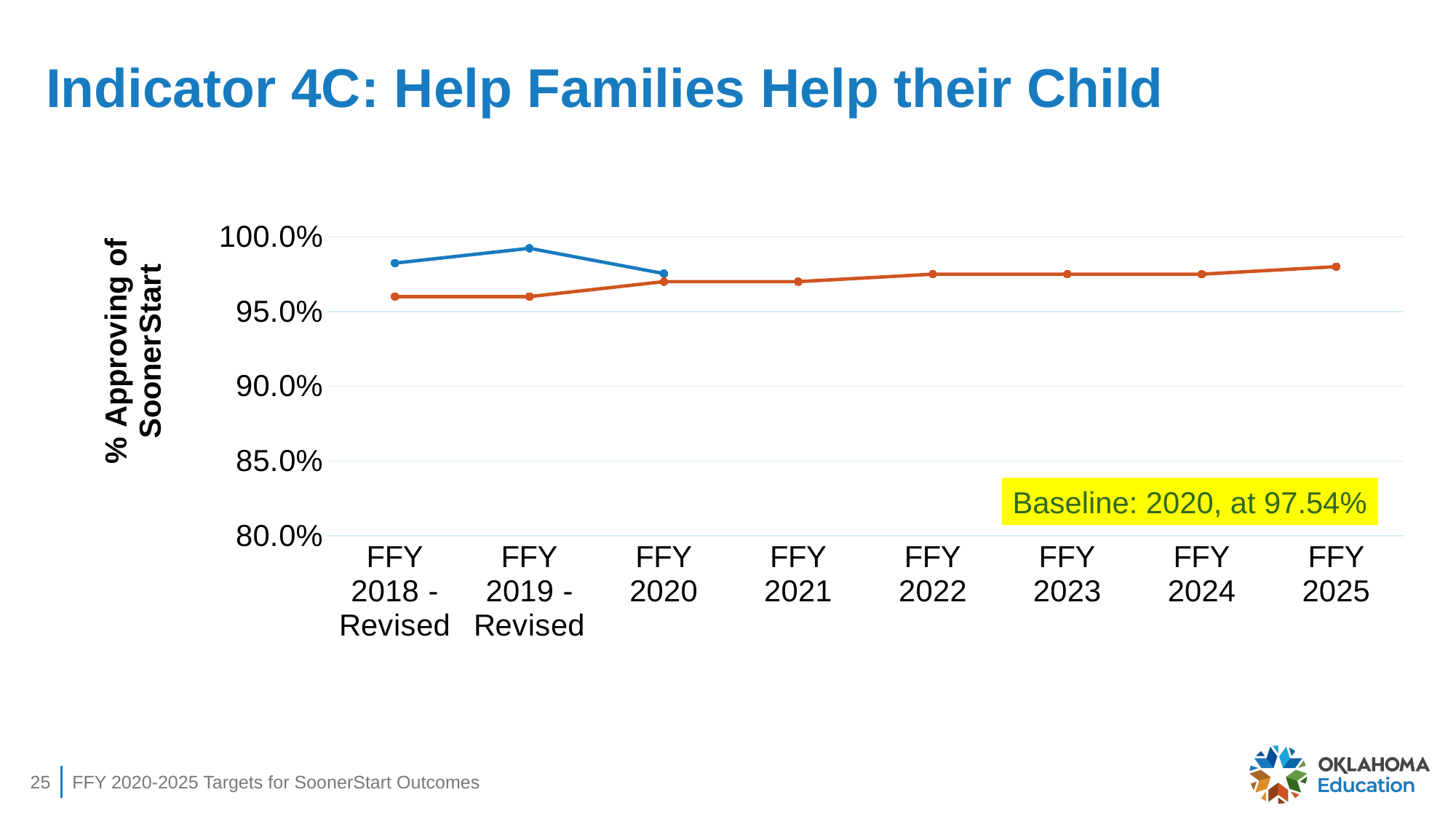
How many categories are shown on the x axis of the chart? 8 Is the value of the orange line at FFY 2025 greater or less than 100.0%? less Is the value of the orange line at FFY 2018 - Revised greater or less than 90.0%? greater What is the title of the y axis? % Approving of SoonerStart Is the value of the blue line at FFY 2019 - Revised greater or less than 95.0%? greater Does the orange line generally rise or fall from FFY 2020 to FFY 2025? Rise How many lines are plotted on the chart? 2 What kind of chart is shown on the slide? Line chart At which category does the blue line reach its highest value? FFY 2019 - Revised At FFY 2019 - Revised, which line has the higher value, the blue line or the orange line? Blue line At which category does the orange line reach its highest value? FFY 2025 According to the highlighted annotation, what is the baseline value for 2020? 97.54%